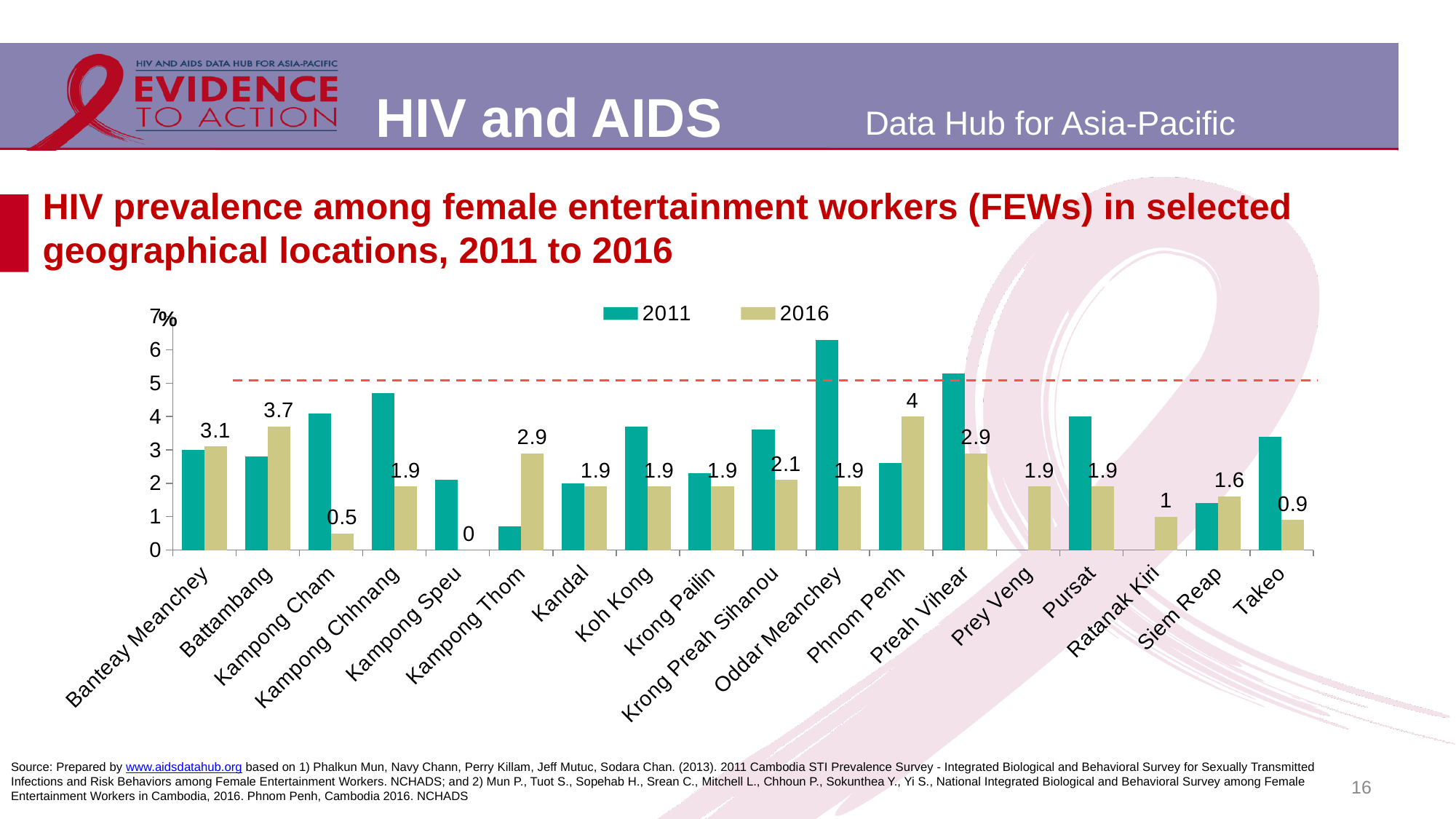
What is the difference between the 2016 values for Phnom Penh and Takeo? 3.1 Which location has the highest 2011 value? Oddar Meanchey How many series does the legend list? 2 Which is larger, the 2016 value for Kampong Thom or the 2016 value for Siem Reap? Kampong Thom How many geographical locations are shown on the x axis? 18 What is the 2016 value for Phnom Penh? 4 Which location has the lowest 2016 value? Kampong Speu Is the 2011 value for Oddar Meanchey greater or less than 6? greater What is the 2016 HIV prevalence value for Battambang? 3.7 What is the 2016 value for Kampong Cham? 0.5 Which location has the highest 2016 value? Phnom Penh What type of chart is shown on the slide? bar chart